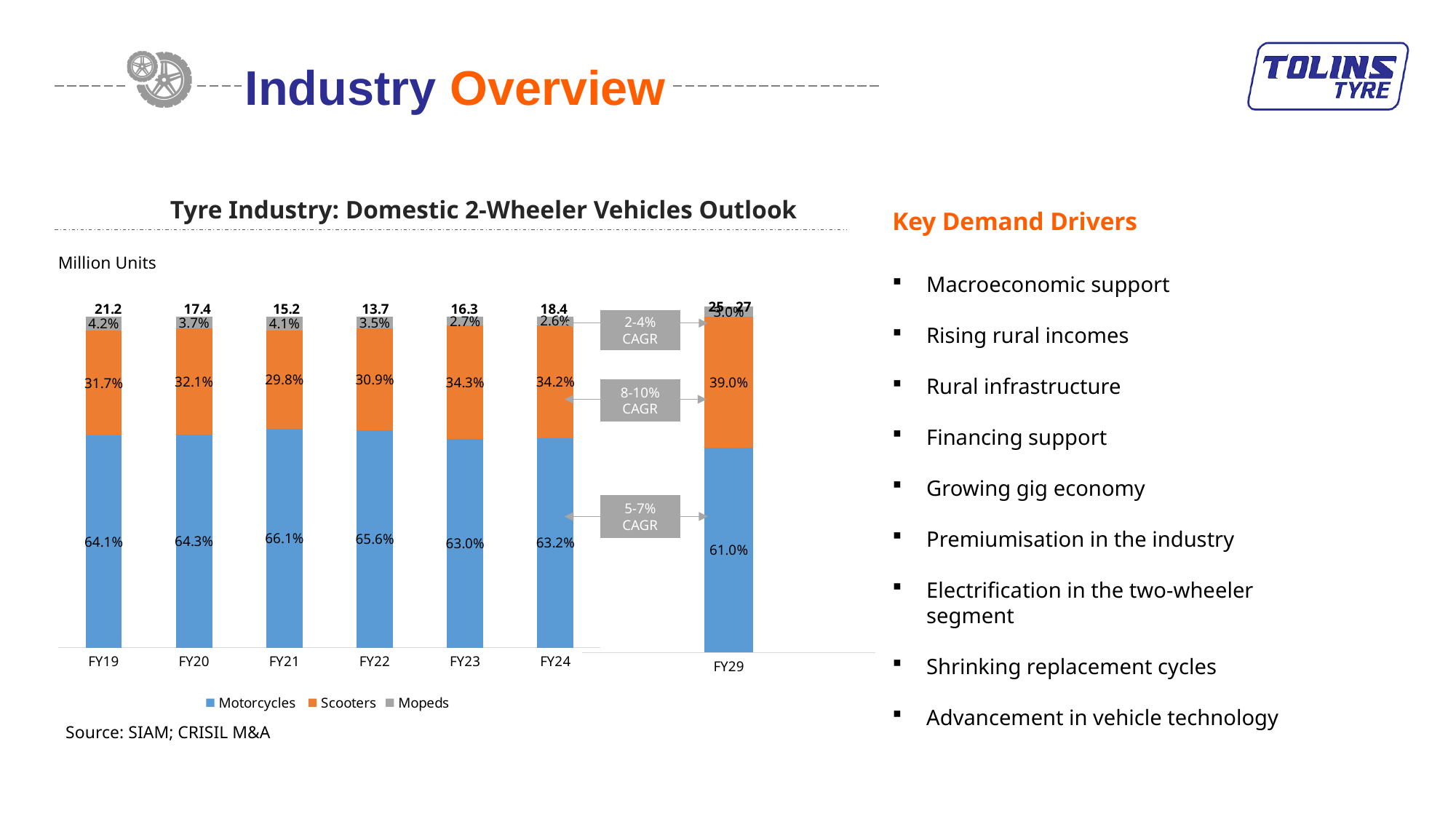
What is the total volume (million units) shown above the FY22 bar? 13.7 What CAGR is shown for Scooters between FY24 and FY29? 8-10% CAGR What is the difference in total volume between FY19 and FY24? 2.8 What type of chart is shown on the slide? Stacked bar chart How many series does the legend list? 3 Which is larger, the Scooters share in FY29 or the Scooters share in FY24? FY29 Which fiscal year from FY19 to FY24 has the lowest total volume? FY22 How many fiscal years are shown on the x axis? 7 What is the Scooters share in FY24? 34.2% What is the Motorcycles share in FY21? 66.1% What is the Mopeds share in FY19? 4.2% Which fiscal year from FY19 to FY24 has the highest total volume? FY19